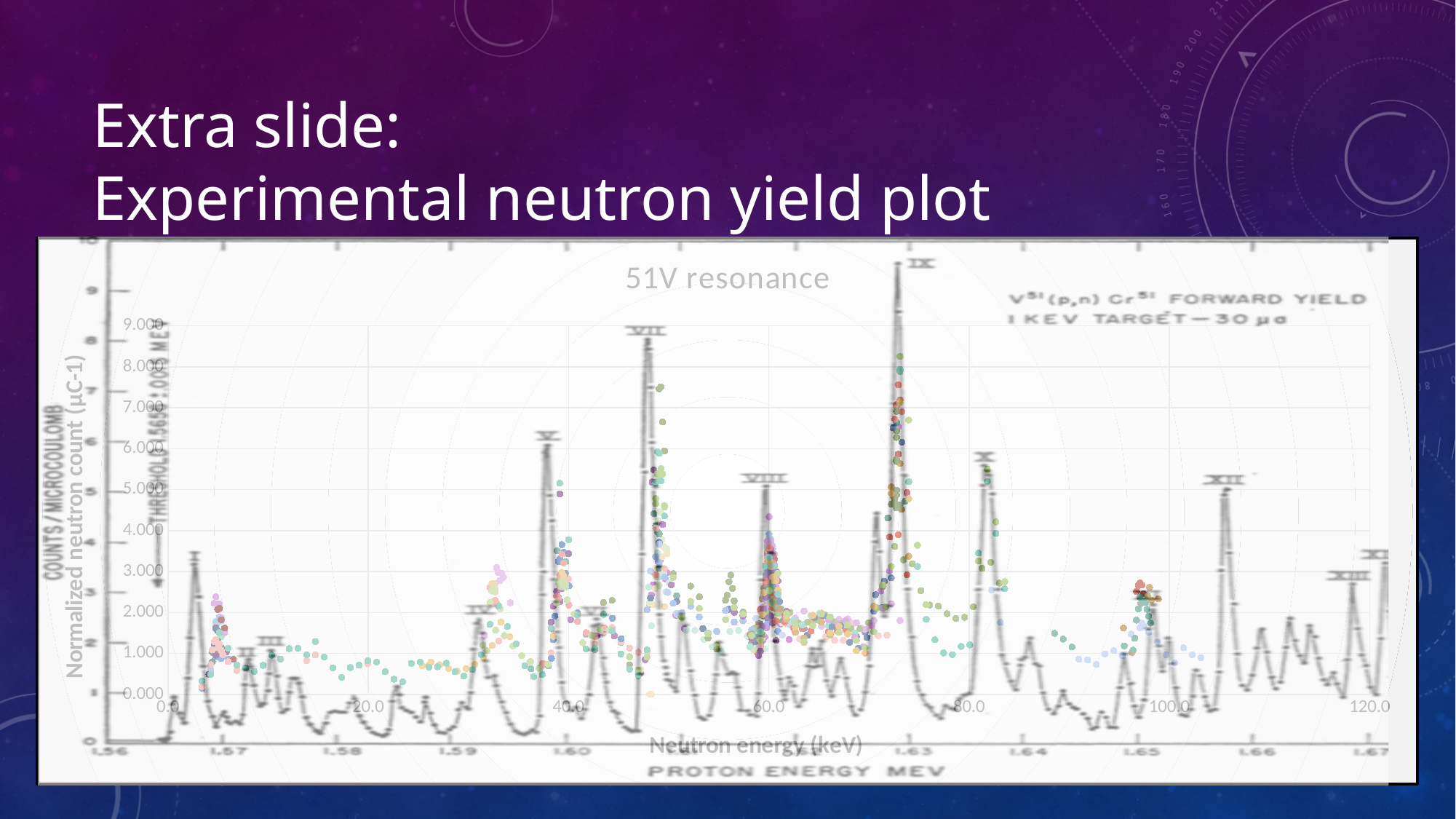
Around which x-axis value do the scatter points reach their highest y value: 20.0 or 75? 75 What is the label of the x axis of the overlaid chart? Neutron energy (keV) Is the highest scatter point near 75 keV greater or less than 7.000 on the y axis? greater Are the scatter points near 20.0 keV greater or less than 2.000 on the y axis? less What is the title of the overlaid chart? 51V resonance What is the highest tick value shown on the y axis of the overlaid chart? 9.000 What is the highest tick value shown on the x axis of the overlaid chart? 120.0 Is the highest scatter point near 50 keV greater or less than 6.000 on the y axis? greater What kind of chart is the overlaid coloured-point plot on the slide? scatter chart